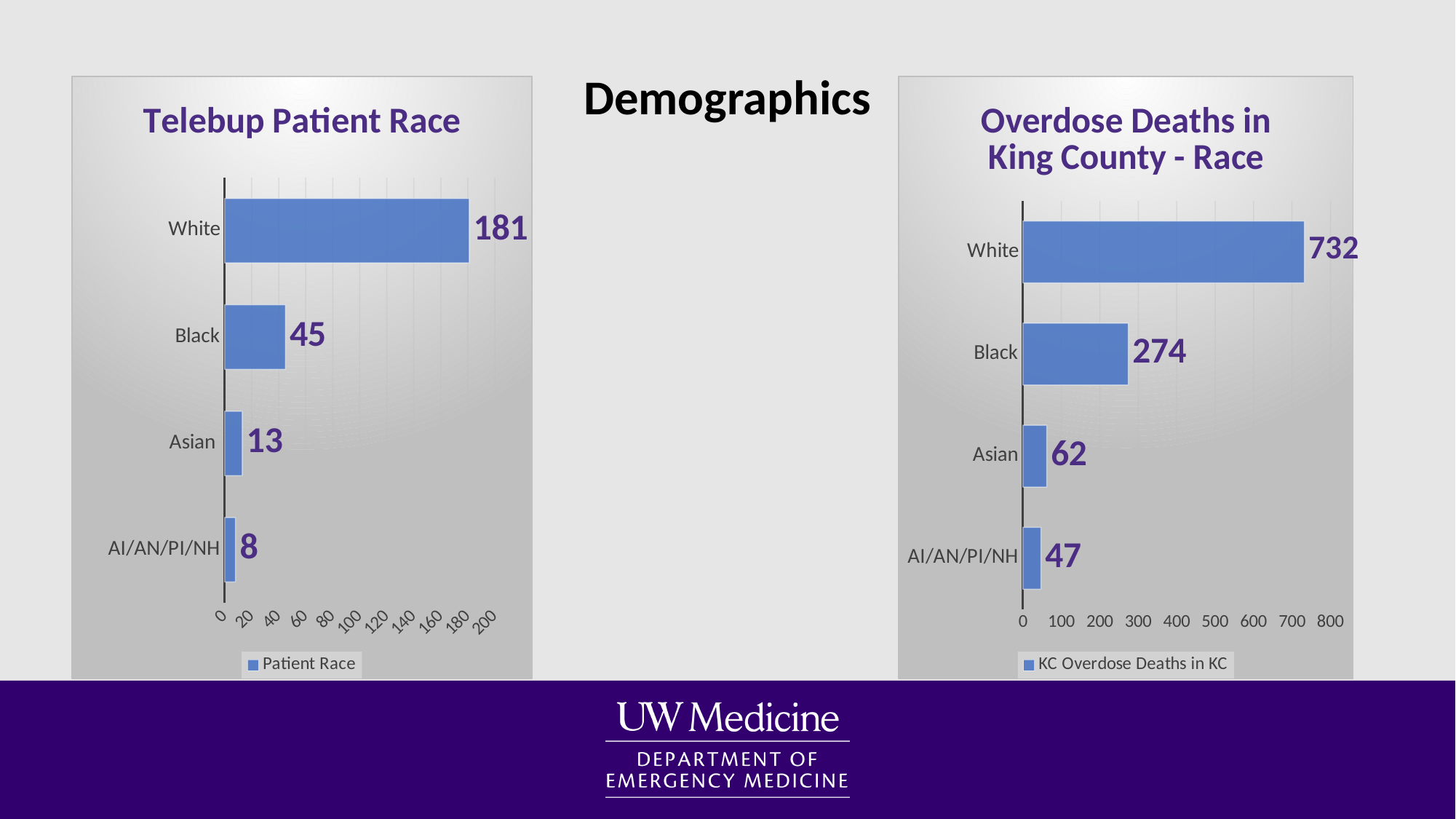
What kind of chart is the Overdose Deaths in King County - Race chart? Bar chart In the Telebup Patient Race chart, what is the difference between the values for White and Black? 136 In the Overdose Deaths in King County - Race chart, what is the difference between the values for Black and Asian? 212 In the Overdose Deaths in King County - Race chart, what is the value for White? 732 How many categories are shown in the Telebup Patient Race chart? 4 In the Telebup Patient Race chart, which category has the highest value? White In the Telebup Patient Race chart, what is the value for Black? 45 In the Overdose Deaths in King County - Race chart, which category has the lowest value? AI/AN/PI/NH In the Overdose Deaths in King County - Race chart, which is larger, the value for Asian or the value for AI/AN/PI/NH? Asian What legend entry is shown for the Overdose Deaths in King County - Race chart? KC Overdose Deaths in KC In the Overdose Deaths in King County - Race chart, what is the value for Asian? 62 In the Telebup Patient Race chart, what is the value for AI/AN/PI/NH? 8